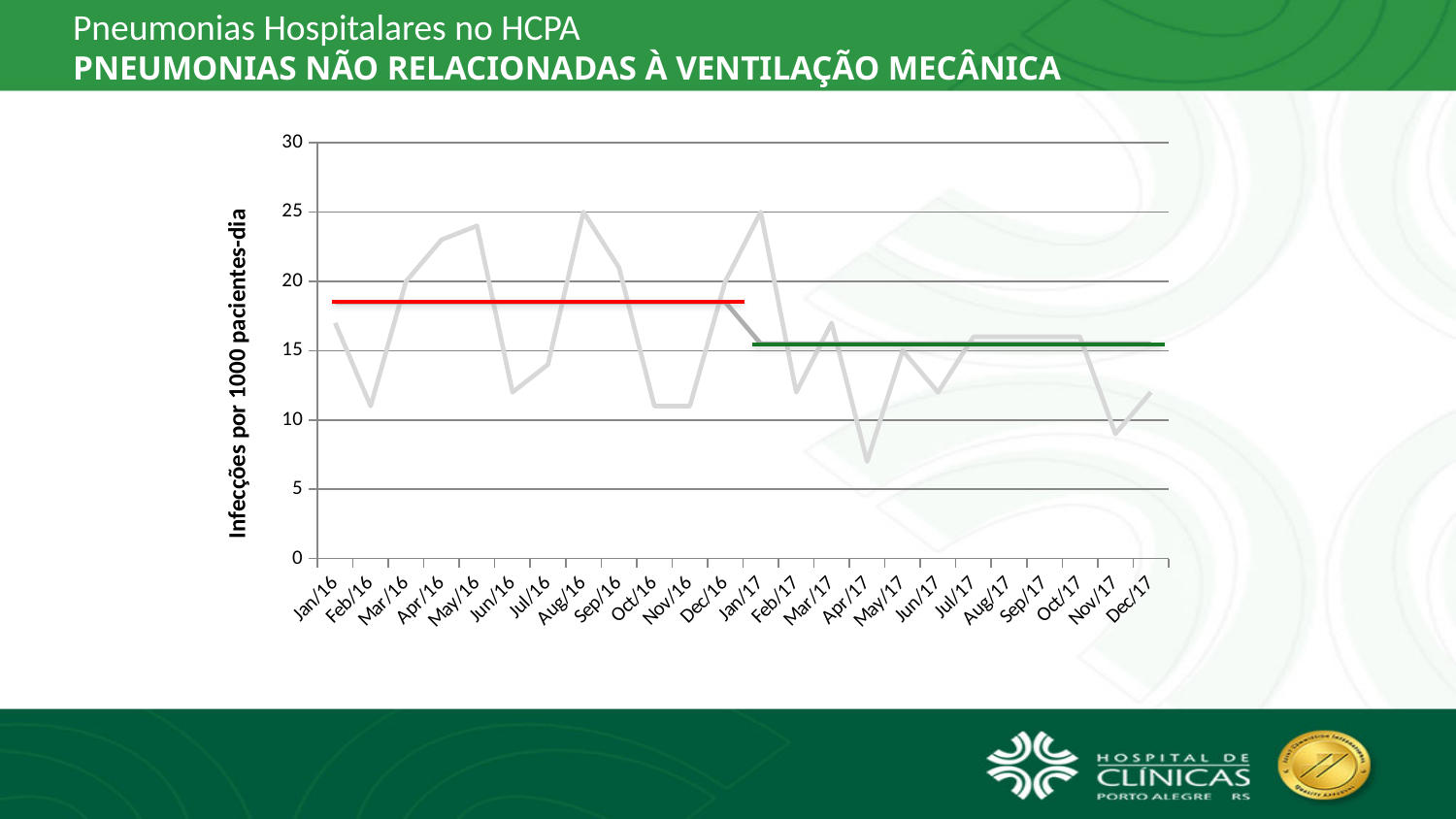
What is the label of the vertical axis of the chart? Infecções por 1000 pacientes-dia Is the value for Feb/16 greater or less than 15? less Which is larger, the value for Aug/16 or the value for Feb/16? Aug/16 What is the highest value shown on the vertical axis of the chart? 30 What kind of chart is shown on the slide? line chart Is the value for Aug/16 greater or less than 20? greater How many months are plotted along the x axis of the chart? 24 Is the value for Apr/17 greater or less than 10? less Which month has the lowest value on the chart? Apr/17 Which is larger, the value for Mar/17 or the value for Apr/17? Mar/17